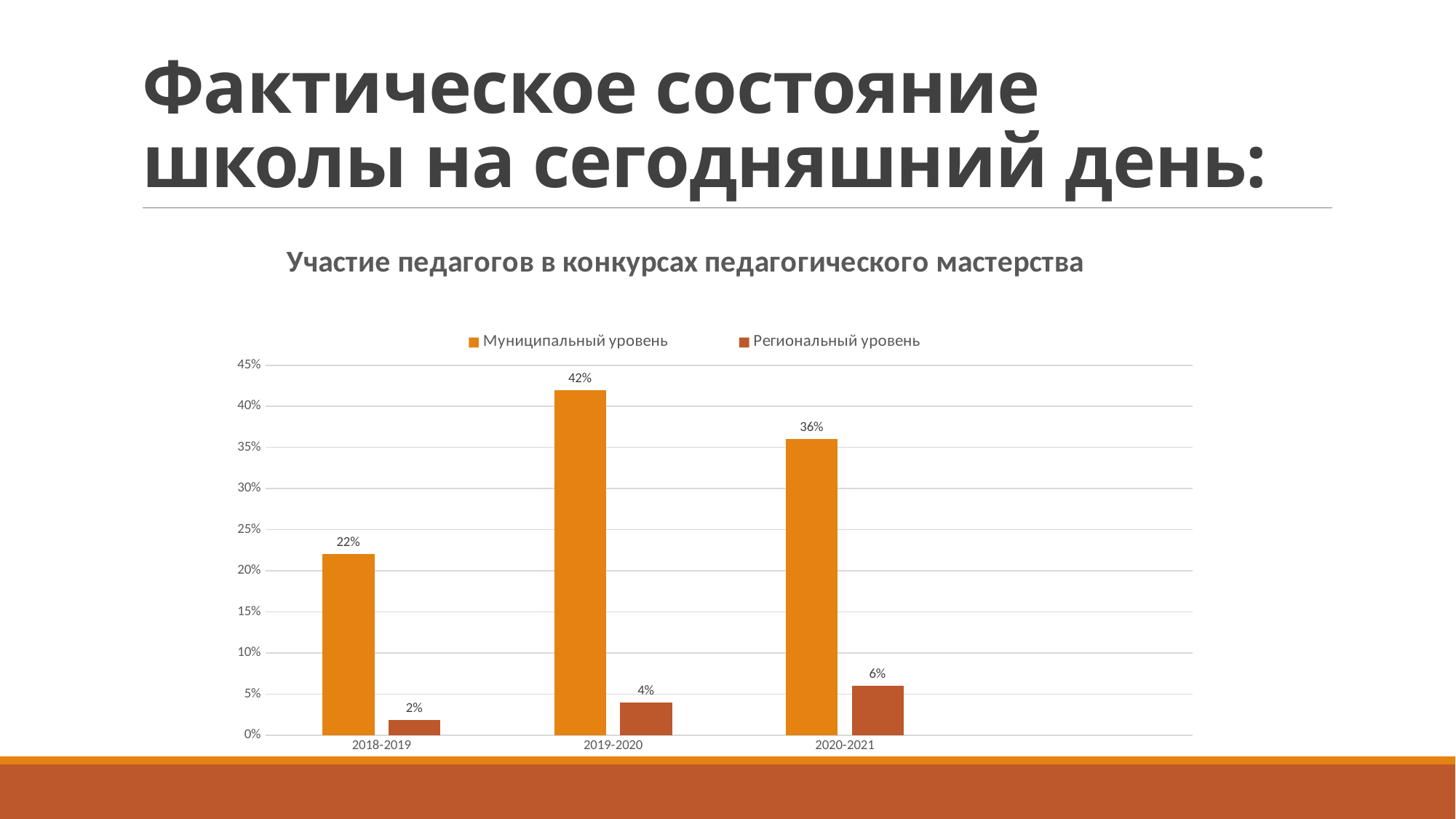
What kind of chart is shown on the slide? Bar chart What is the value for Муниципальный уровень in 2020-2021? 36% What is the difference between the Муниципальный уровень values for 2019-2020 and 2018-2019? 20% What is the title of the chart? Участие педагогов в конкурсах педагогического мастерства In which year is the Региональный уровень value lowest? 2018-2019 How many series does the legend list? 2 In which year is the Муниципальный уровень value highest? 2019-2020 How many year categories are shown on the x axis? 3 Which is larger: Региональный уровень in 2019-2020 or in 2020-2021? 2020-2021 What is the value for Региональный уровень in 2020-2021? 6% What is the value for Муниципальный уровень in 2019-2020? 42% What is the value for Региональный уровень in 2018-2019? 2%